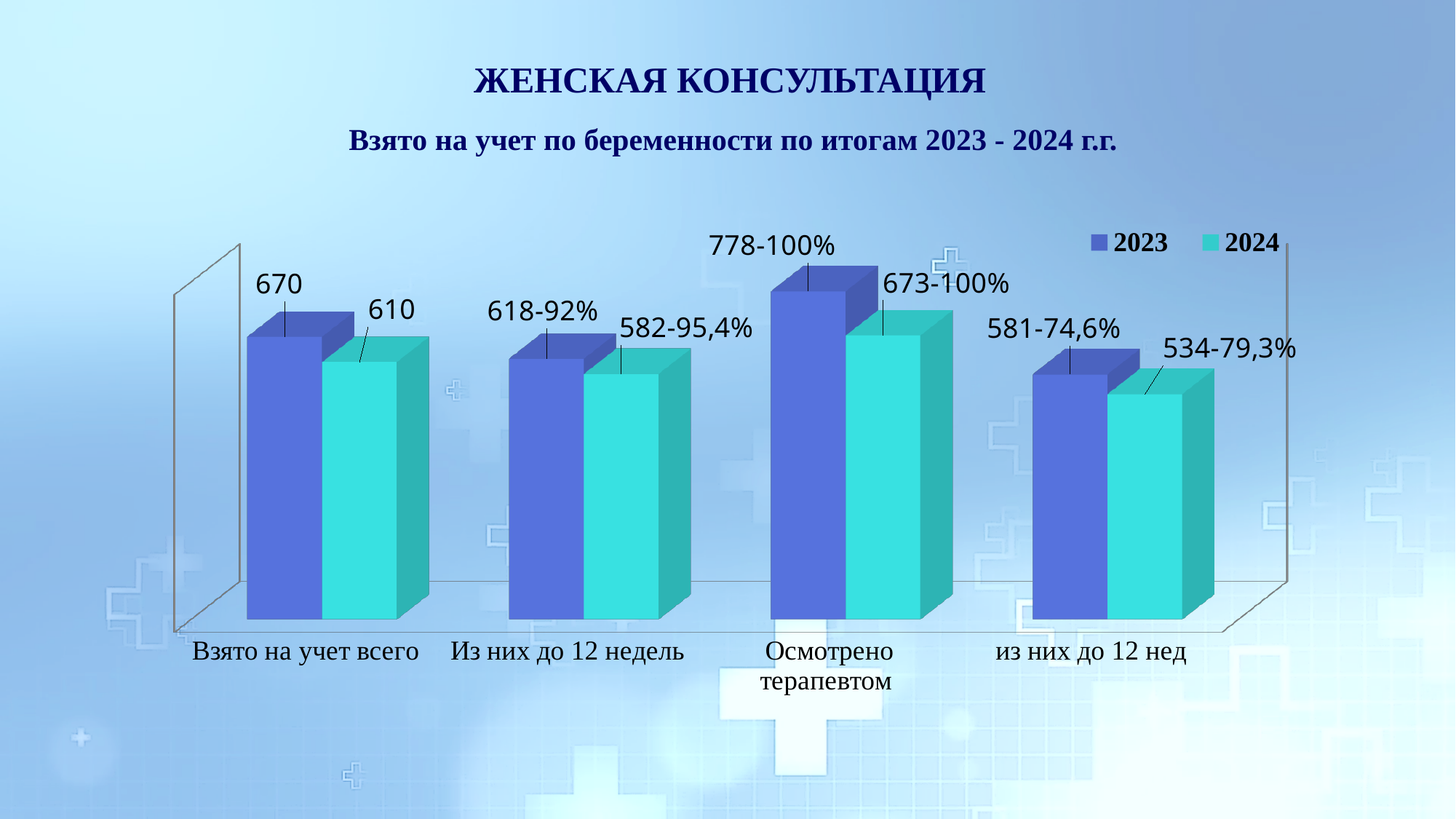
By how much does the 2023 value exceed the 2024 value in the category "Взято на учет всего"? 60 What is the data label for 2024 in the category "Взято на учет всего"? 610 Which category has the lowest 2024 value? из них до 12 нед What is the difference between the 2023 count (778) and the 2024 count (673) in the category "Осмотрено терапевтом"? 105 What is the data label for 2023 in the category "Из них до 12 недель"? 618-92% What is the data label for 2024 in the category "Осмотрено терапевтом"? 673-100% What is the data label for 2024 in the category "из них до 12 нед"? 534-79,3% What is the data label for 2023 in the category "Взято на учет всего"? 670 How many series does the legend list? 2 In the category "из них до 12 нед", which series has the larger value, 2023 or 2024? 2023 How many categories are shown on the x axis of the chart? 4 Which category has the highest 2023 value? Осмотрено терапевтом